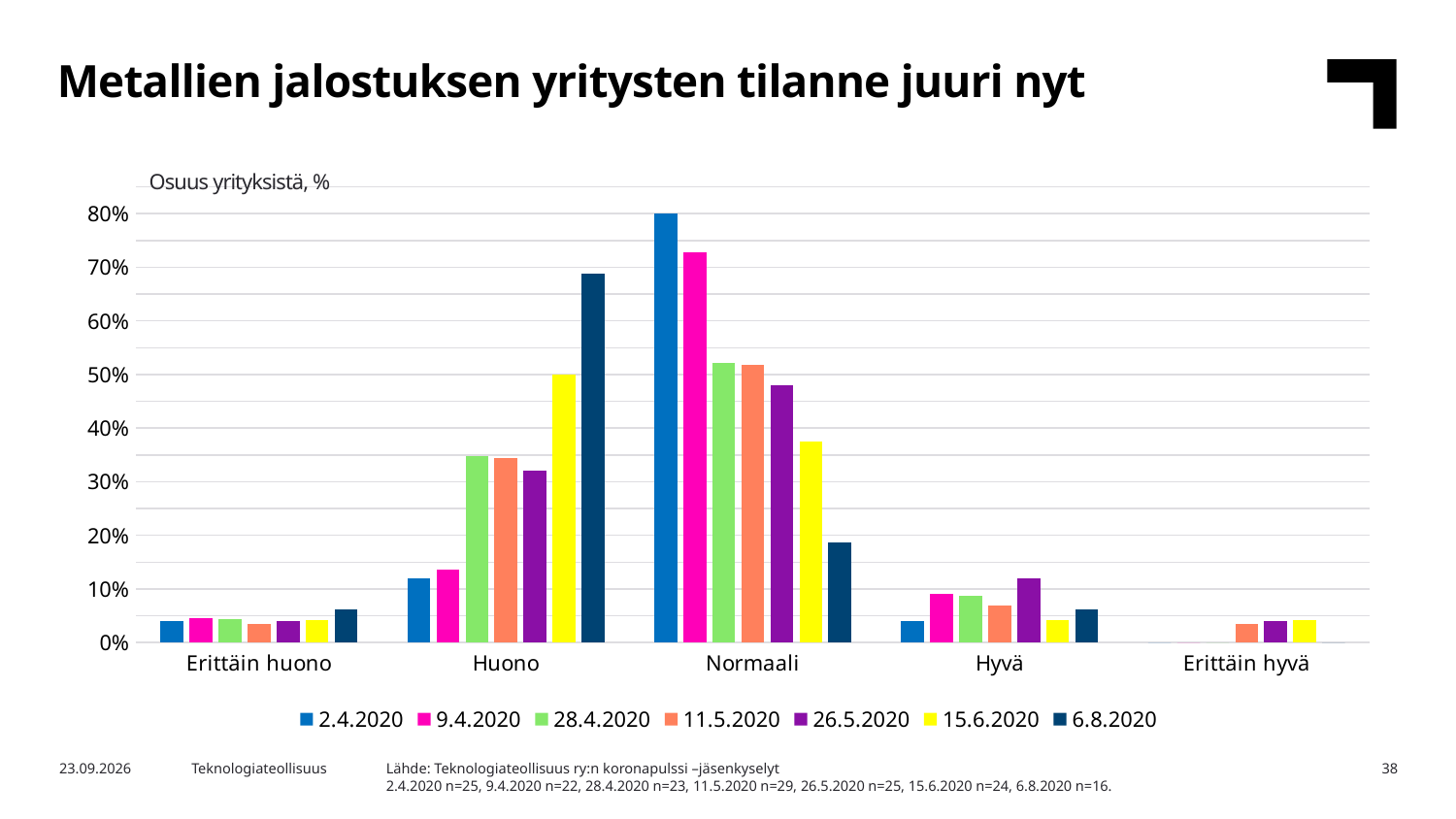
What is the value for Normaali in the 2.4.2020 series? 80% Which category has the highest value for the 6.8.2020 series? Huono What is the value for Huono in the 15.6.2020 series? 50% Is the value for Normaali in the 6.8.2020 series greater or less than 20%? less How many series does the legend list? 7 What is the title of the chart? Metallien jalostuksen yritysten tilanne juuri nyt Which category has the highest value for the 2.4.2020 series? Normaali For the Normaali category, which is larger: the 2.4.2020 value or the 15.6.2020 value? 2.4.2020 For the Huono category, do the values rise or fall from the 2.4.2020 series to the 6.8.2020 series? rise What kind of chart is shown on the slide? bar chart Is the value for Huono in the 6.8.2020 series greater or less than 60%? greater How many categories are shown on the x axis? 5